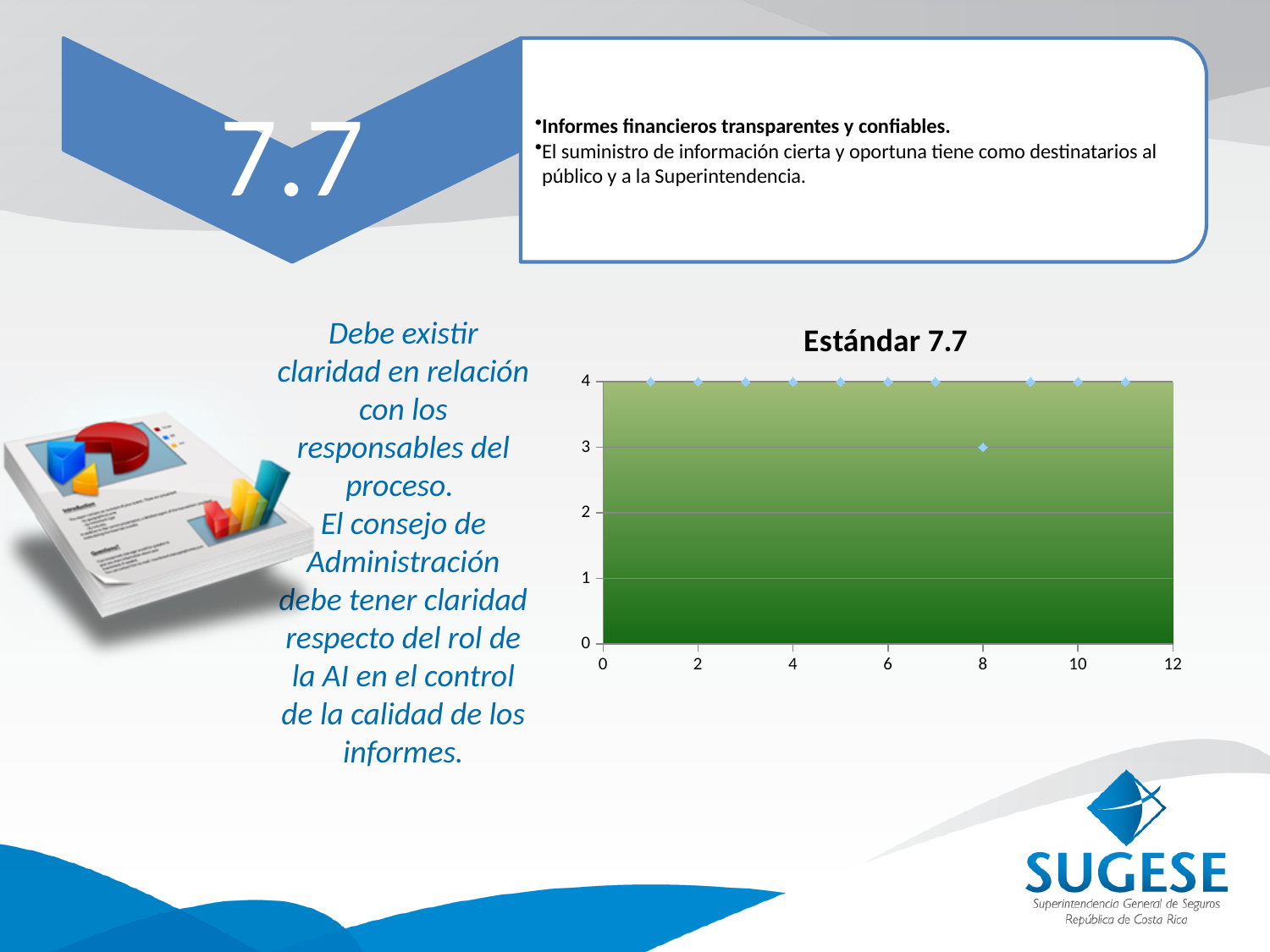
At which x value does the lowest point occur? 8 What type of chart is shown on the slide? scatter chart What is the title of the chart? Estándar 7.7 What is the y value of the point at x = 1? 4 How many data points are plotted in the chart? 11 Is the y value of the point at x = 8 greater or less than 2? greater What is the difference between the y value at x = 7 and the y value at x = 8? 1 What is the highest y value reached by any point in the chart? 4 What is the y value of the point at x = 11? 4 Which point has a larger y value, the one at x = 8 or the one at x = 9? x = 9 What is the y value of the point at x = 8? 3 What is the maximum value shown on the x axis? 12